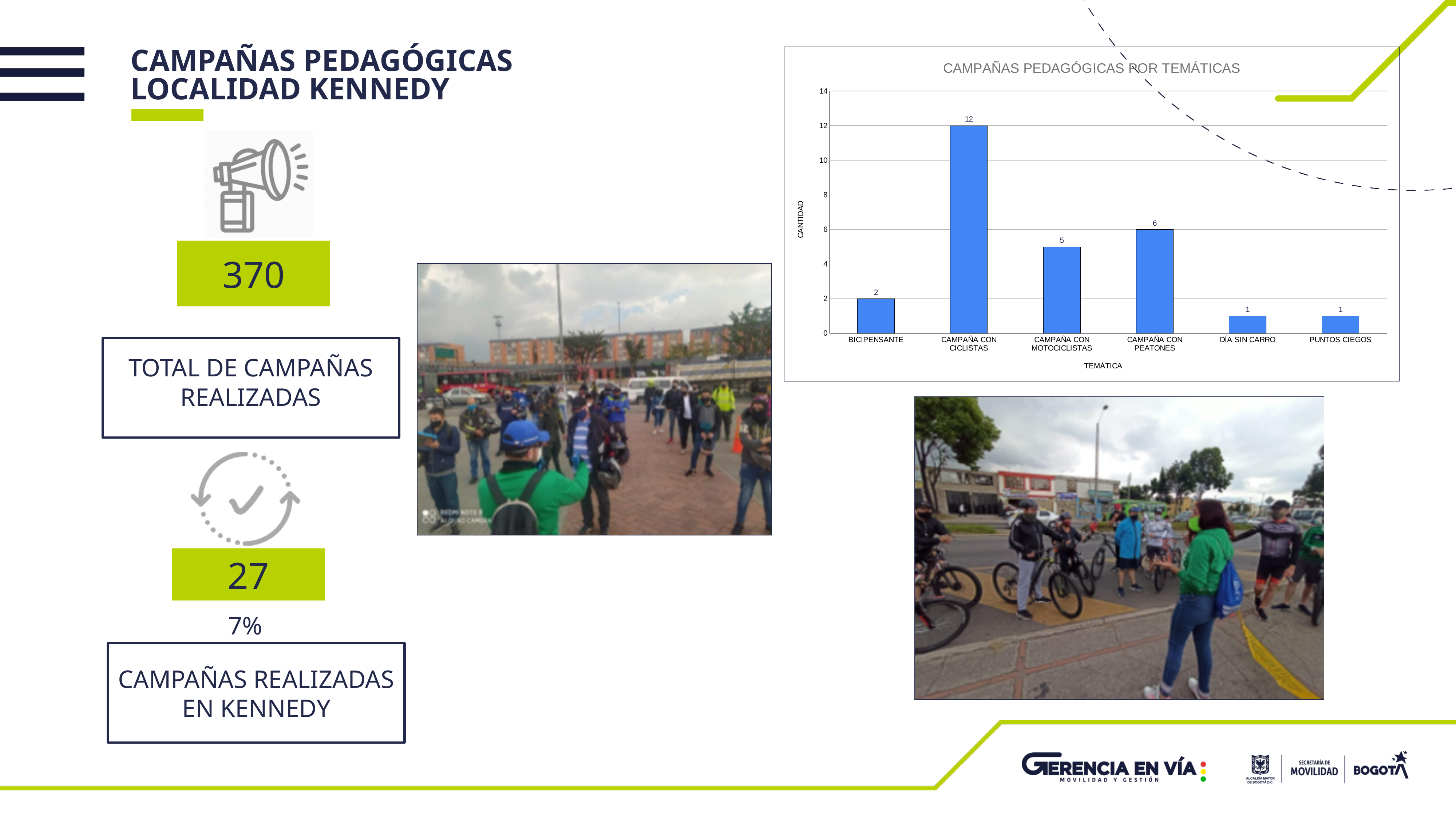
What is the value for CAMPAÑA CON PEATONES? 6 Is the value for CAMPAÑA CON CICLISTAS greater or less than 10? greater What kind of chart is shown? bar chart How many categories are shown on the x axis? 6 Which category has the highest value? CAMPAÑA CON CICLISTAS What is the value for CAMPAÑA CON MOTOCICLISTAS? 5 What is the difference between CAMPAÑA CON CICLISTAS and CAMPAÑA CON PEATONES? 6 What is the value for BICIPENSANTE? 2 Which is larger, CAMPAÑA CON MOTOCICLISTAS or BICIPENSANTE? CAMPAÑA CON MOTOCICLISTAS What is the value for CAMPAÑA CON CICLISTAS? 12 What is the title of the chart? CAMPAÑAS PEDAGÓGICAS POR TEMÁTICAS What is the label of the y axis? CANTIDAD